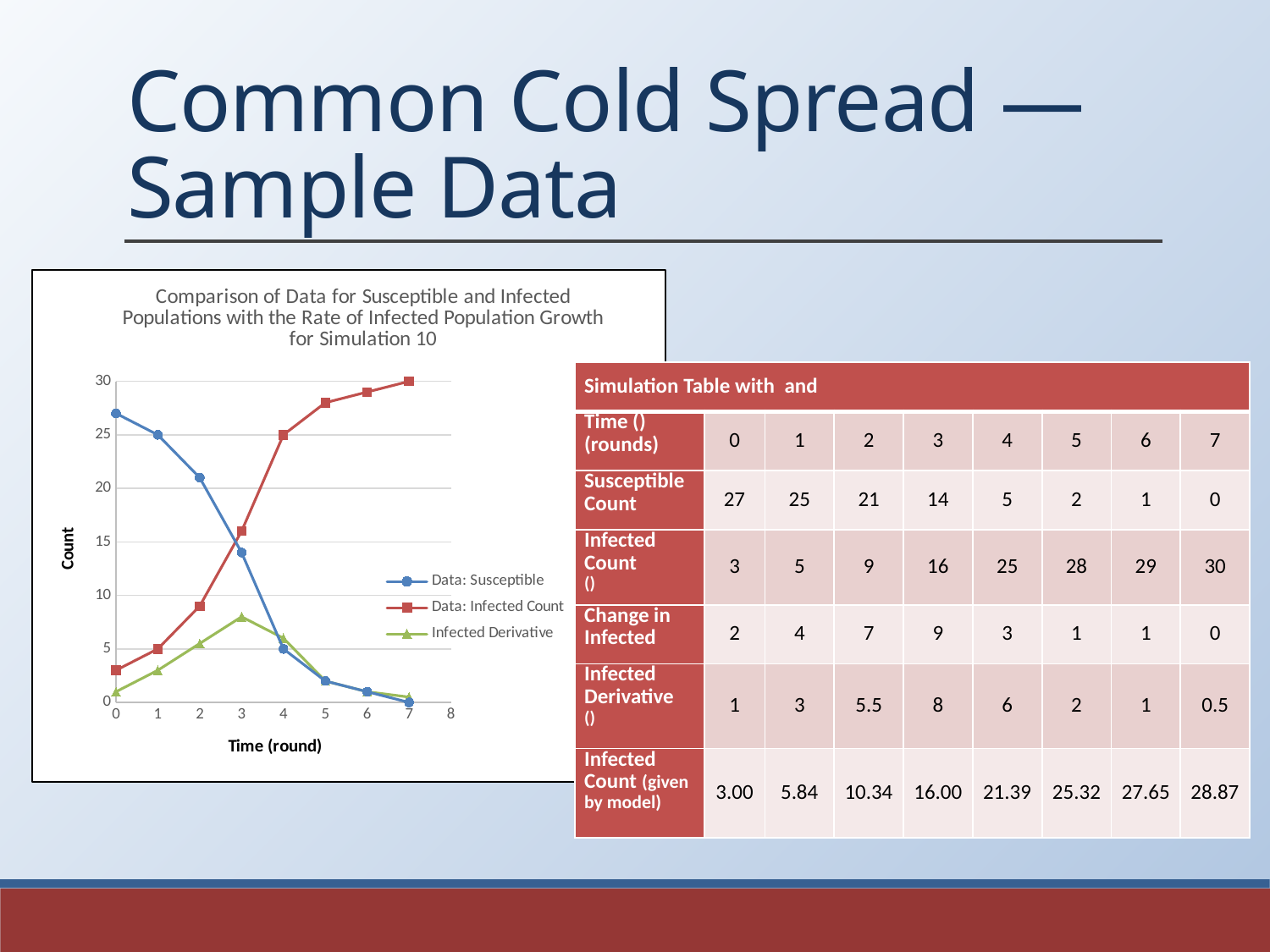
What kind of chart is shown on the slide? line chart What is the value of Data: Infected Count at round 4? 25 At round 1, which is larger: Data: Susceptible or Data: Infected Count? Data: Susceptible Does the Data: Susceptible series rise or fall as time increases? fall What is the value of Data: Susceptible at round 1? 25 What is the value of Data: Susceptible at round 7? 0 Which series has the highest value at round 7? Data: Infected Count Does the Data: Infected Count series rise or fall as time increases? rise What is the difference between Data: Infected Count and Data: Susceptible at round 7? 30 Is the value of Infected Derivative at round 3 greater or less than 10? less What is the value of Data: Infected Count at round 7? 30 How many series does the chart's legend list? 3